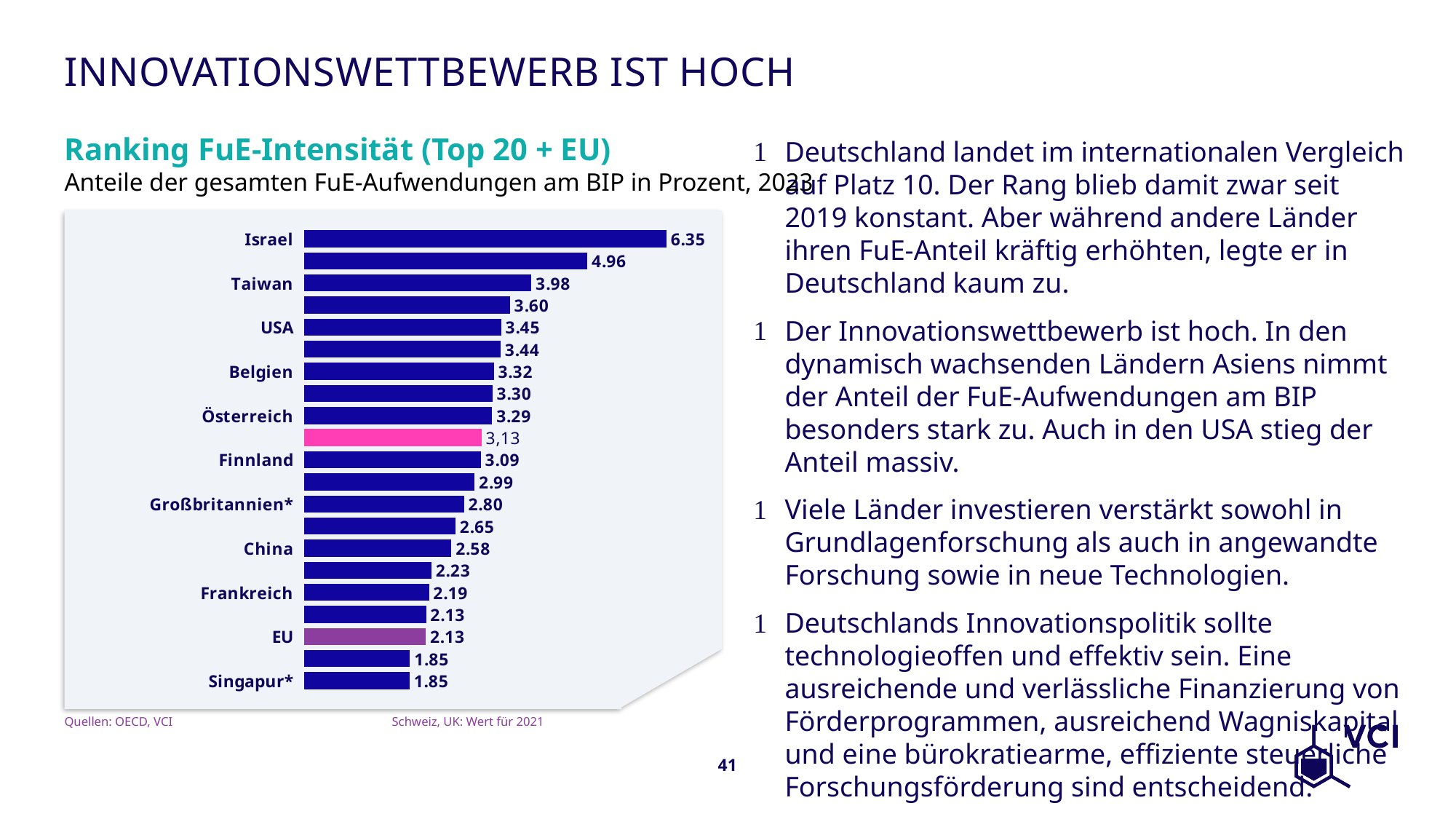
What kind of chart is shown? Bar chart What is the difference between the values for Israel and Taiwan? 2.37 What is the value for Belgien? 3.32 What is the difference between the values for USA and China? 0.87 How many bars are shown in the chart? 21 What is the value for EU? 2.13 What is the value for Israel? 6.35 What is the value for Taiwan? 3.98 Which is larger, the value for Belgien or the value for Frankreich? Belgien Which country has the highest value? Israel What is the value for USA? 3.45 What is the value for Singapur*? 1.85